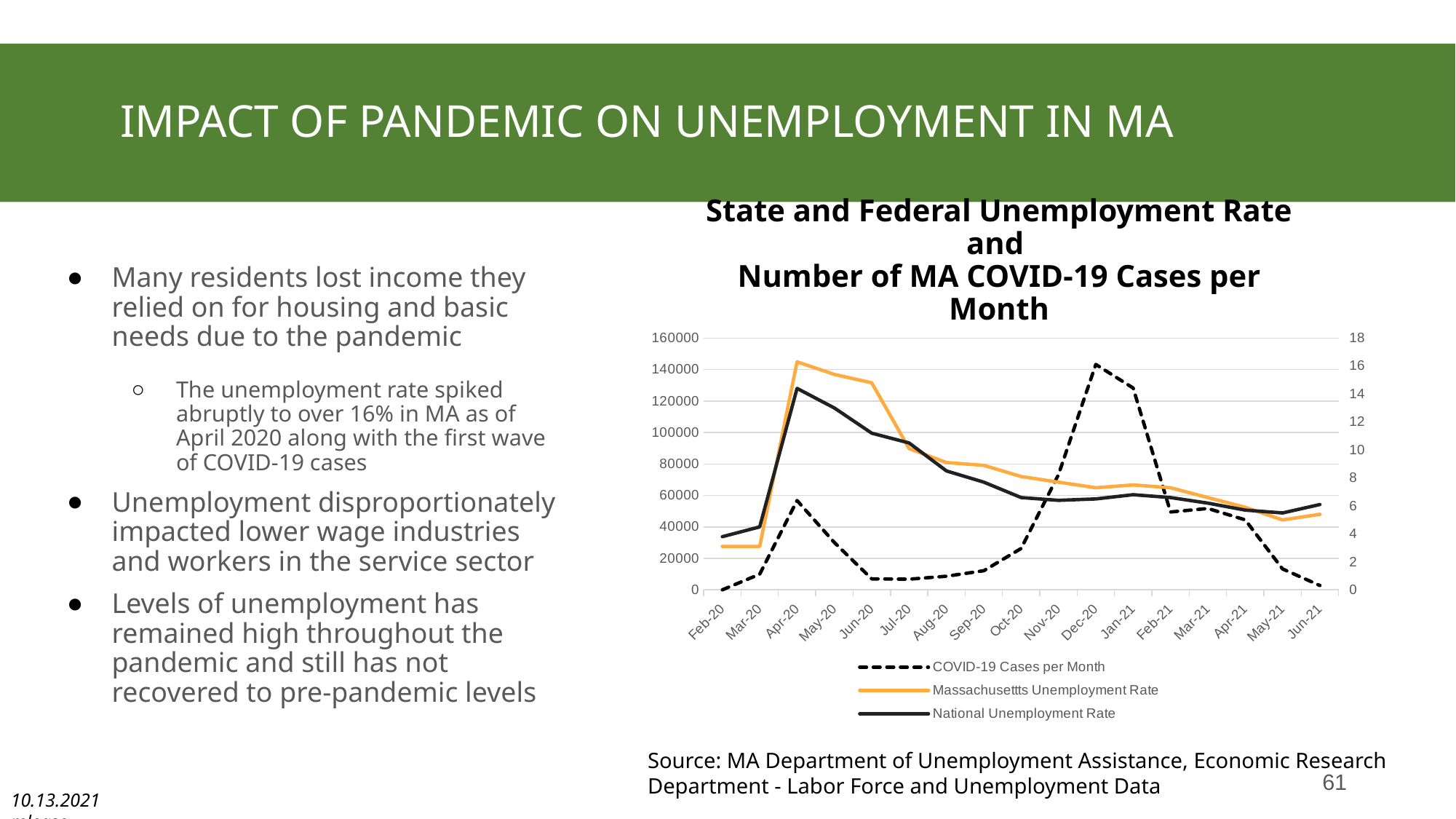
In which month is the COVID-19 Cases per Month series at its lowest value? Feb-20 What kind of chart is shown on the slide? Line chart Is the Massachusetts Unemployment Rate for Apr-20 greater or less than 14 on the right axis? greater How many months are plotted along the x axis? 17 Does the Massachusetts Unemployment Rate rise or fall from Apr-20 to Jun-21? Fall How many series does the legend list? 3 Is the COVID-19 Cases per Month value for Jun-20 greater or less than 20000? less In Apr-20, which is higher: the Massachusetts Unemployment Rate or the National Unemployment Rate? Massachusetts Unemployment Rate In which month does the Massachusetts Unemployment Rate series reach its highest value? Apr-20 Is the COVID-19 Cases per Month value for Dec-20 greater or less than 120000? greater In which month does the COVID-19 Cases per Month series reach its highest value? Dec-20 Which series is drawn with a dashed line? COVID-19 Cases per Month